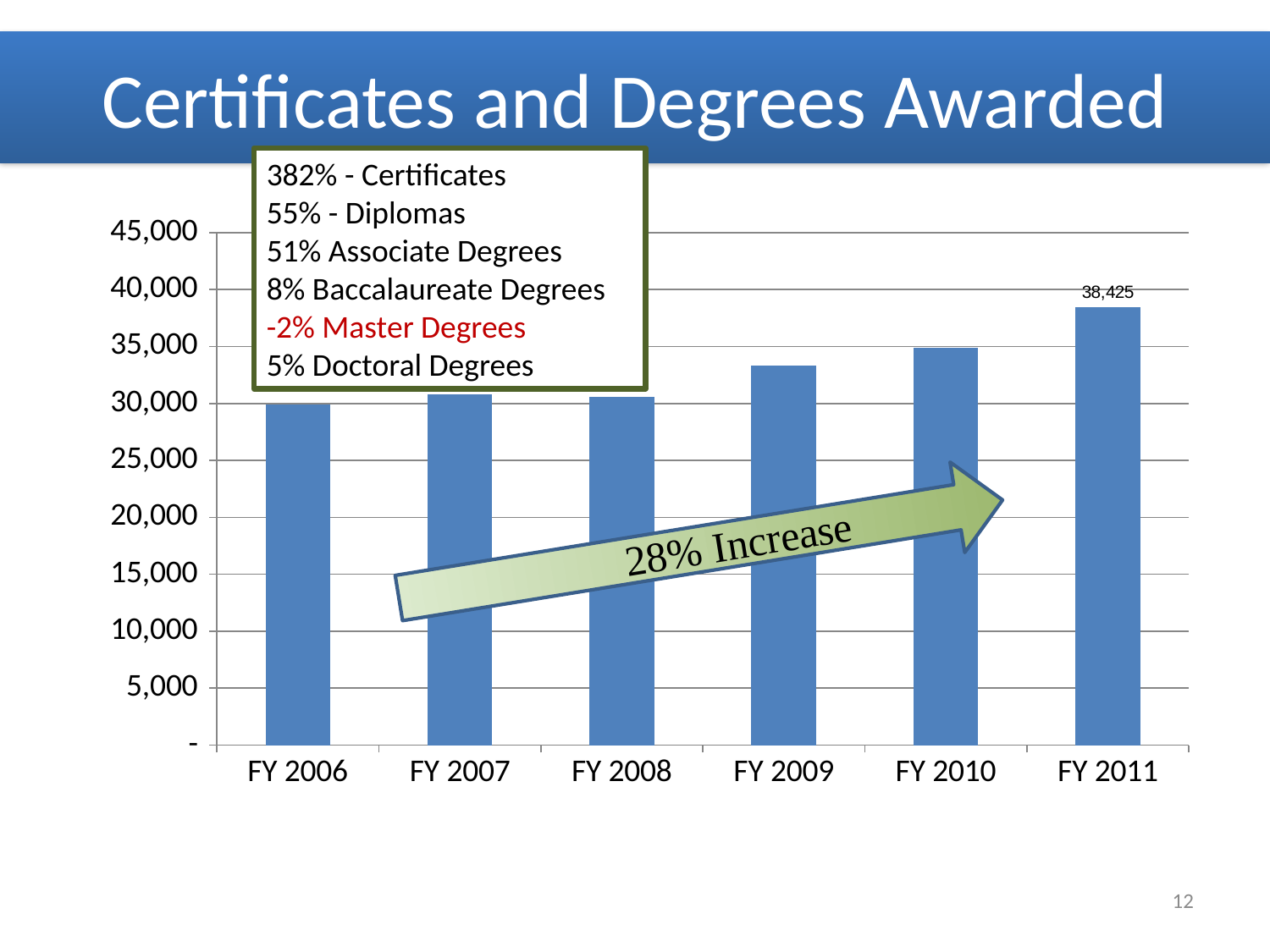
Which is larger, the value for FY 2010 or the value for FY 2009? FY 2010 What value is labelled on the bar for FY 2011? 38,425 Is the value for FY 2009 greater or less than 30,000? greater What percentage increase is written on the arrow overlaid on the chart? 28% Increase Is the value for FY 2010 greater or less than 40,000? less Is the value for FY 2009 greater or less than 35,000? less Do the values generally rise or fall from FY 2006 to FY 2011? Rise What kind of chart is shown on the slide? Bar chart Which fiscal year has the highest number of certificates and degrees awarded? FY 2011 How many fiscal years are shown on the x axis of the chart? 6 Which is larger, the value for FY 2011 or the value for FY 2006? FY 2011